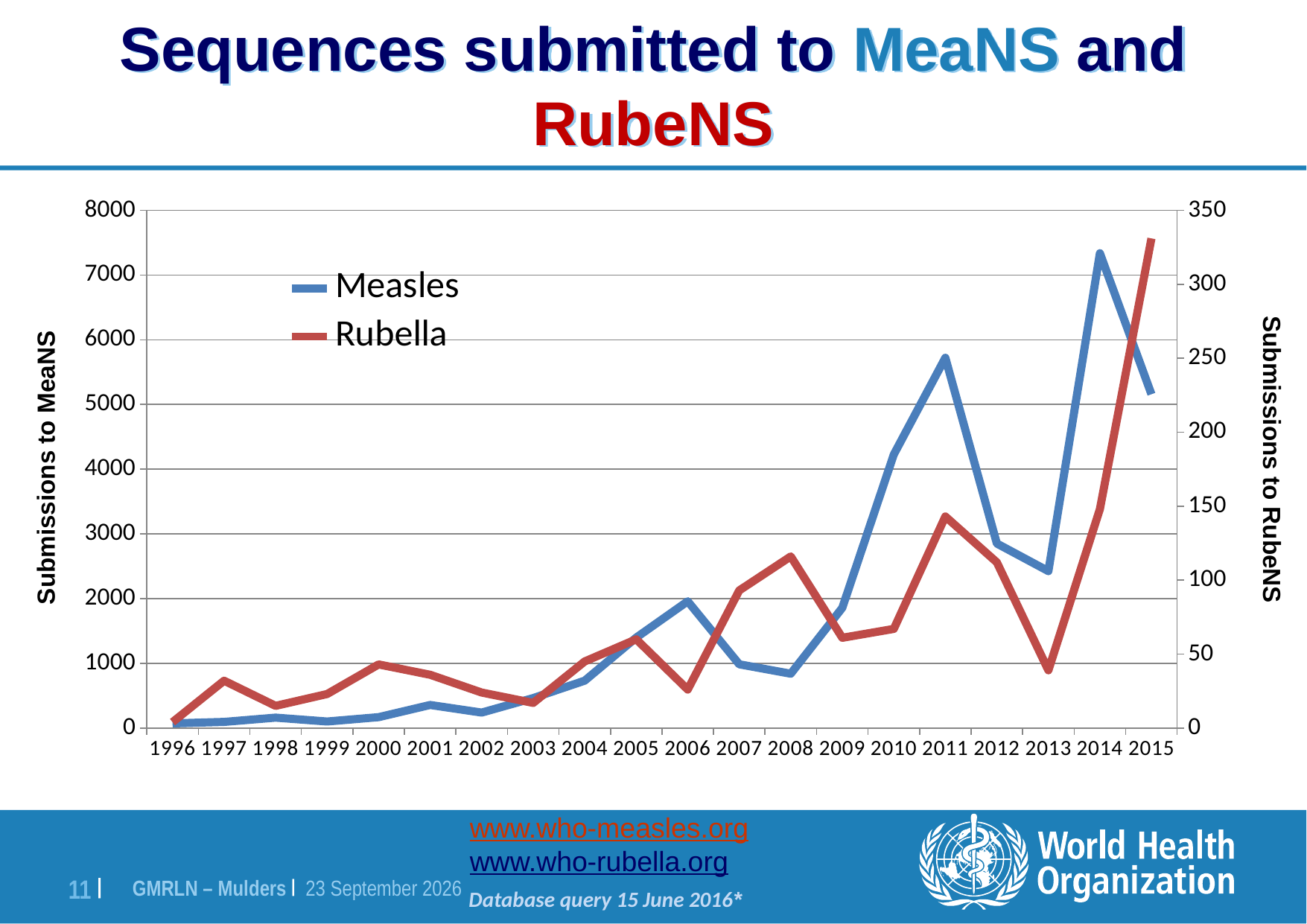
How many series does the legend list? 2 What kind of chart is shown on the slide? line chart In which year does the Measles series reach its highest value? 2014 Does the Measles series rise or fall from 2014 to 2015? fall Is the Rubella value for 2013 greater or less than 50? less In which year does the Rubella series reach its highest value? 2015 In which year is the Rubella series at its lowest value? 1996 Is the Measles value for 2014 greater or less than 7000? greater Is the Rubella value for 2011 greater or less than 100? greater What is the title of the right-hand vertical axis? Submissions to RubeNS How many years are plotted along the x axis? 20